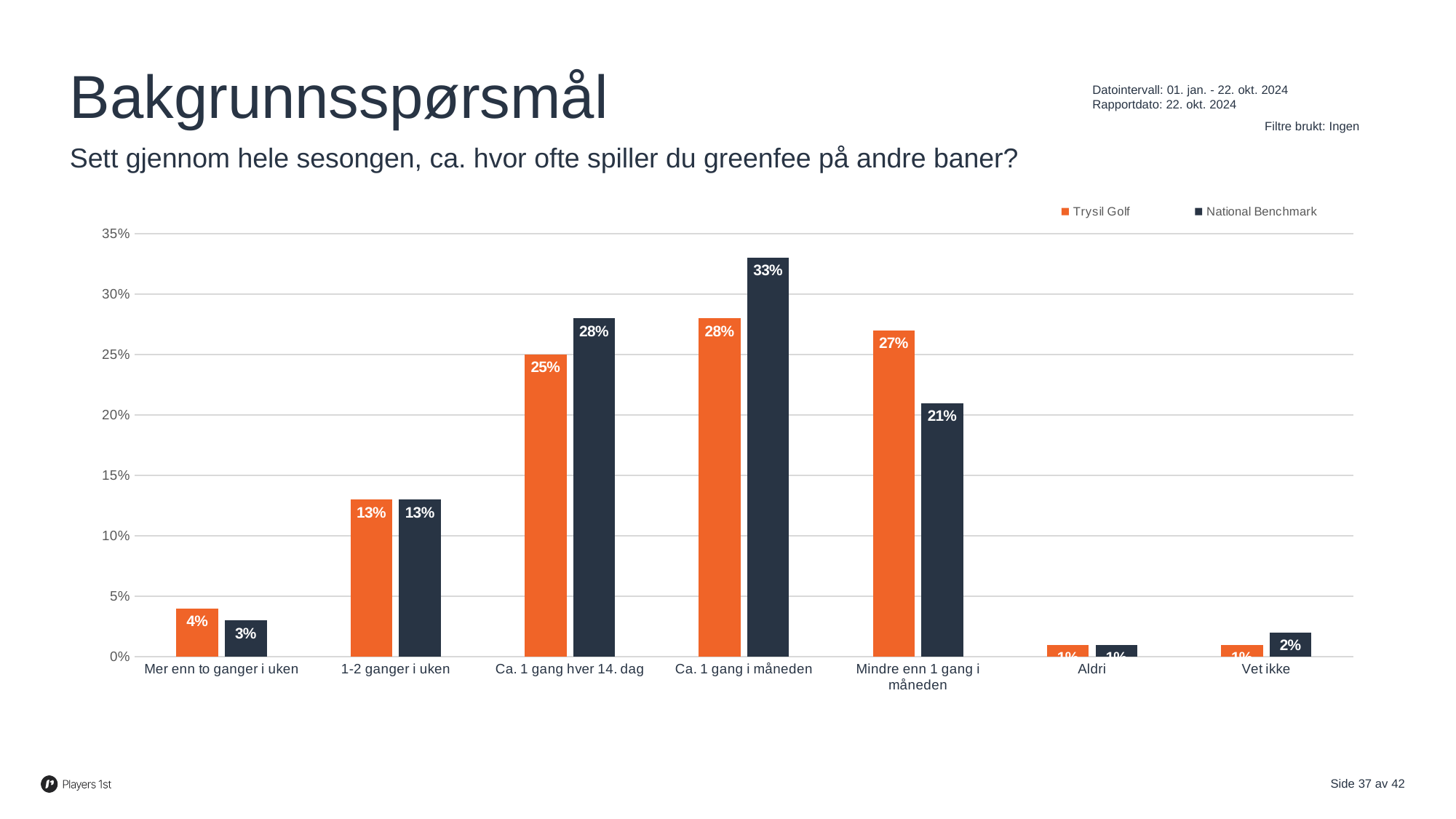
For "Mindre enn 1 gang i måneden", which series has the larger value, Trysil Golf or National Benchmark? Trysil Golf What is the difference between the National Benchmark and Trysil Golf values for "Ca. 1 gang i måneden"? 5% What kind of chart is shown on the slide? bar chart What is the National Benchmark value for "Ca. 1 gang i måneden"? 33% What is the Trysil Golf value for "Mer enn to ganger i uken"? 4% How many categories are shown on the x axis? 7 Is the National Benchmark value for "Ca. 1 gang hver 14. dag" greater or less than 25%? greater What is the National Benchmark value for "Mindre enn 1 gang i måneden"? 21% What is the Trysil Golf value for "Ca. 1 gang hver 14. dag"? 25% How many series does the legend list? 2 Which series is shown in orange in the legend? Trysil Golf Which category has the highest National Benchmark value? Ca. 1 gang i måneden